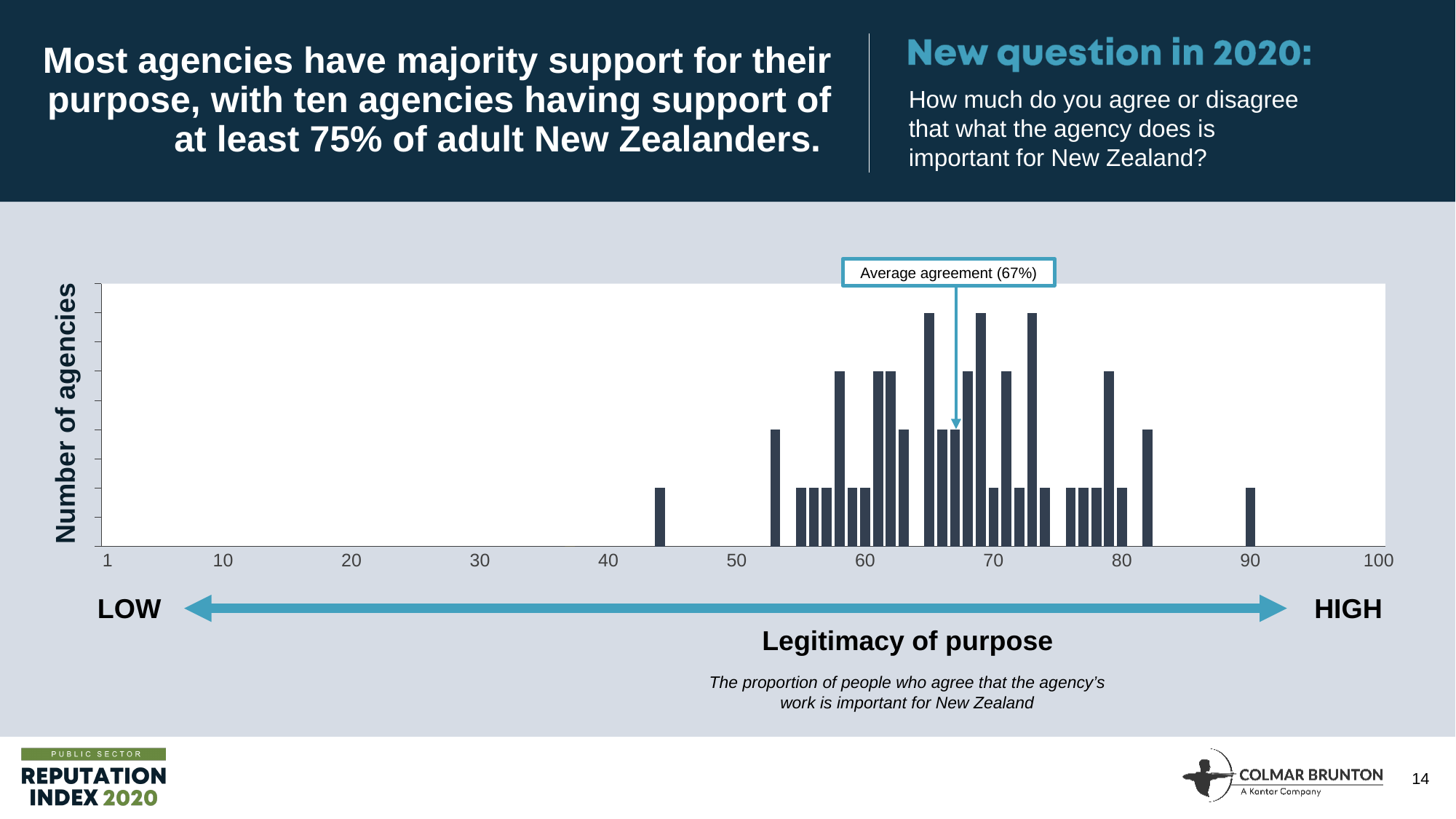
What is the average agreement value annotated on the chart? 67% Which is taller: the bar near 65 or the bar near 44 on the horizontal axis? the bar near 65 What is the label of the horizontal axis? Legitimacy of purpose Is the average agreement marked on the chart greater or less than 60? greater What kind of chart is shown on the slide? bar chart What is the label of the vertical axis? Number of agencies Is the average agreement marked on the chart greater or less than 70? less Which is taller: the bar near 90 or the bar near 73 on the horizontal axis? the bar near 73 What is the highest tick value shown on the horizontal axis? 100 What is the lowest tick value shown on the horizontal axis? 1 How many tick labels are shown on the horizontal axis? 11